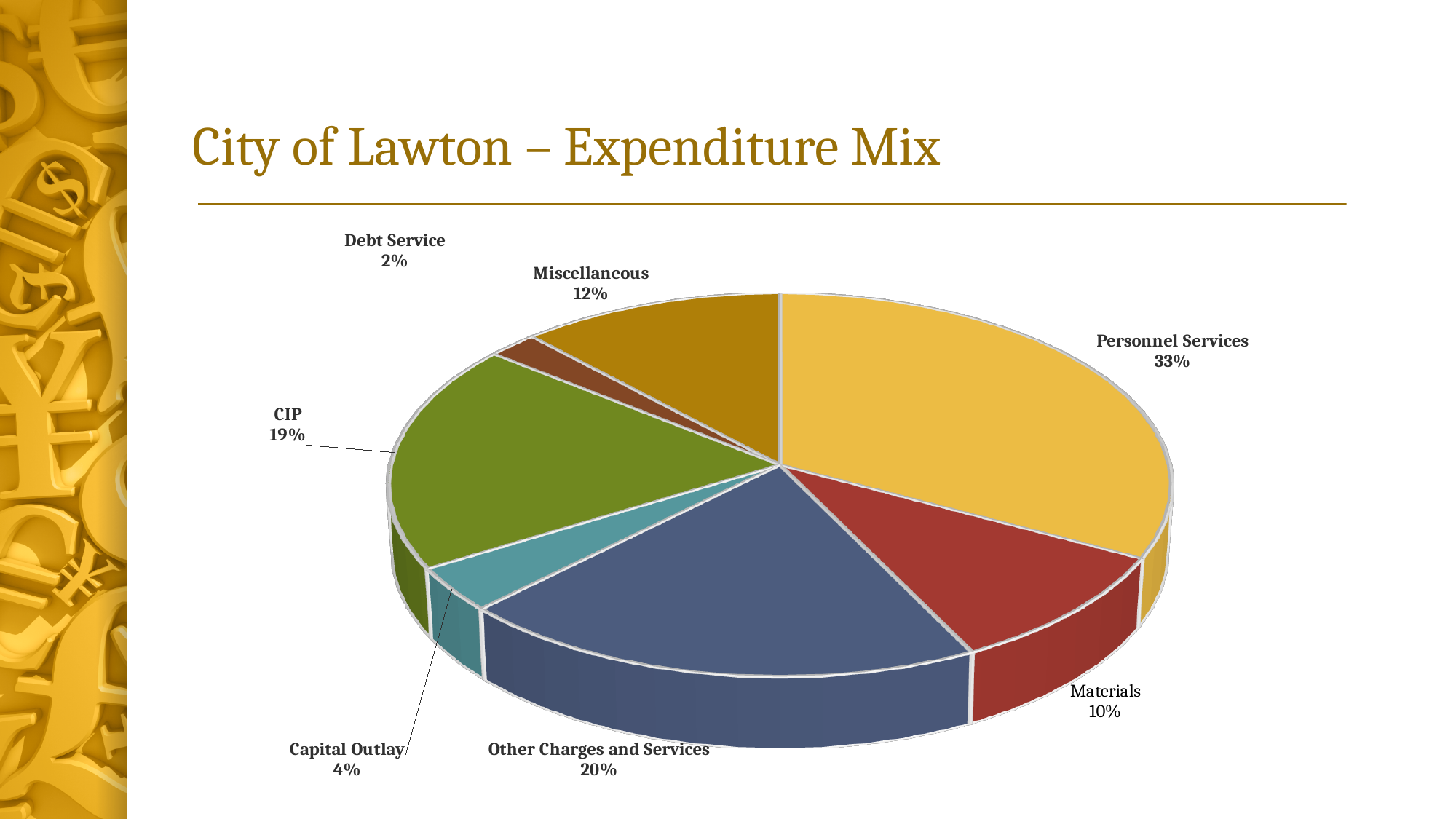
How many categories are shown in the pie chart? 7 What percentage of the expenditure mix is CIP? 19% Which category has the largest share of the expenditure mix? Personnel Services Which category has the smallest share of the expenditure mix? Debt Service What is the difference in percentage points between Personnel Services and Other Charges and Services? 13 What is the combined share of Capital Outlay and Materials? 14% Which is larger, the share for Miscellaneous or the share for Materials? Miscellaneous What share of expenditure is Personnel Services? 33% What is the title of the slide? City of Lawton – Expenditure Mix What share does Other Charges and Services represent? 20% What percentage is shown for Debt Service? 2% What type of chart is shown on the slide? Pie chart